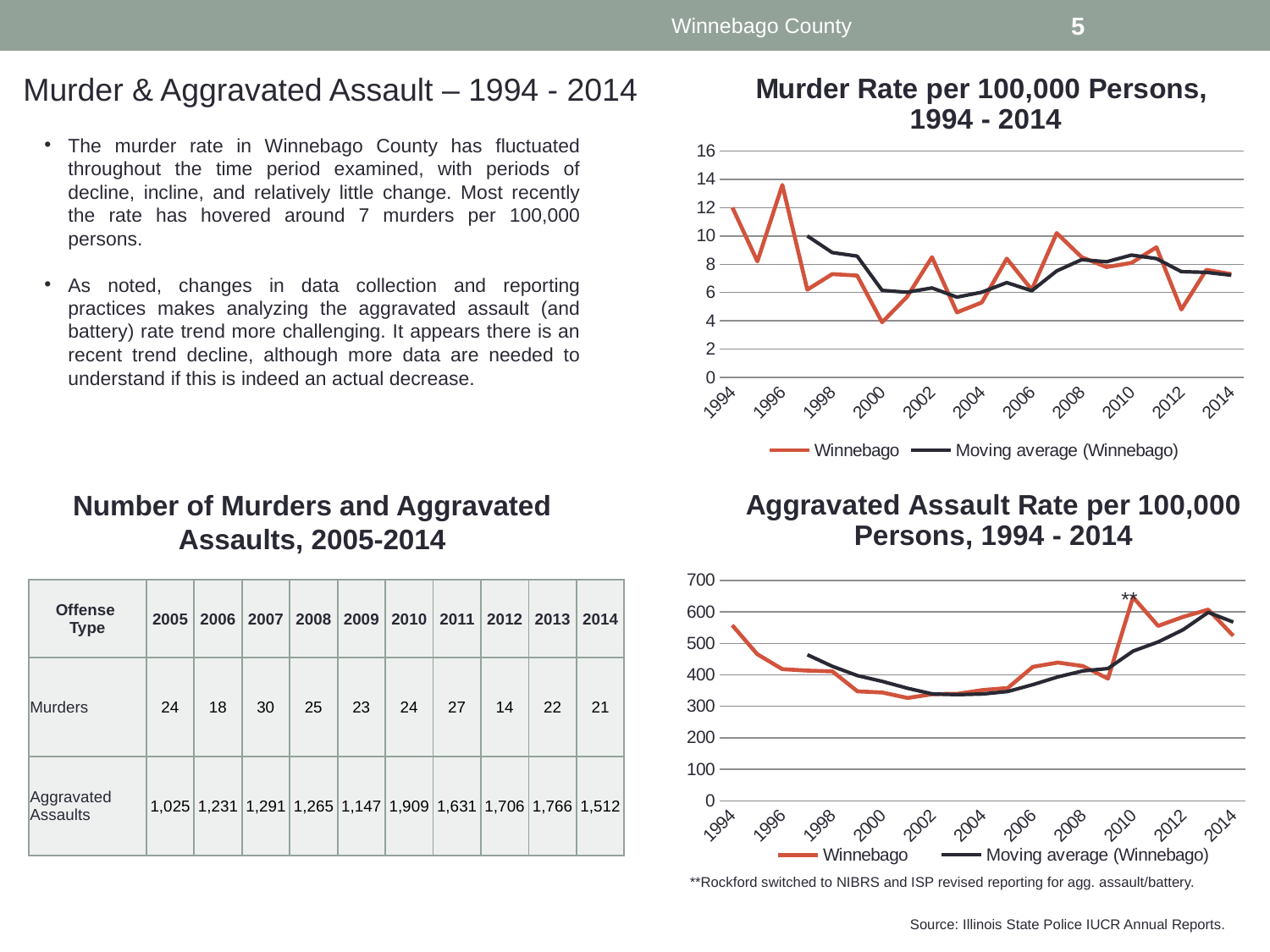
In the 'Aggravated Assault Rate per 100,000 Persons, 1994 - 2014' chart, is the Winnebago value for 2002 greater or less than 400? less What kind of chart is the 'Murder Rate per 100,000 Persons, 1994 - 2014' chart? Line chart In the 'Murder Rate per 100,000 Persons, 1994 - 2014' chart, which is larger, the Winnebago value for 1996 or for 2000? 1996 In the 'Murder Rate per 100,000 Persons, 1994 - 2014' chart, is the Winnebago value for 2000 greater or less than 6? less In the 'Aggravated Assault Rate per 100,000 Persons, 1994 - 2014' chart, is the Winnebago value for 2010 greater or less than 600? greater In the 'Aggravated Assault Rate per 100,000 Persons, 1994 - 2014' chart, does the Winnebago line rise or fall from 2013 to 2014? Fall In the 'Murder Rate per 100,000 Persons, 1994 - 2014' chart, which year has the highest Winnebago murder rate? 1996 How many series does the legend of the 'Aggravated Assault Rate per 100,000 Persons, 1994 - 2014' chart list? 2 What are the two legend entries in the 'Murder Rate per 100,000 Persons, 1994 - 2014' chart? Winnebago and Moving average (Winnebago) In the 'Aggravated Assault Rate per 100,000 Persons, 1994 - 2014' chart, which year has the highest Winnebago aggravated assault rate? 2010